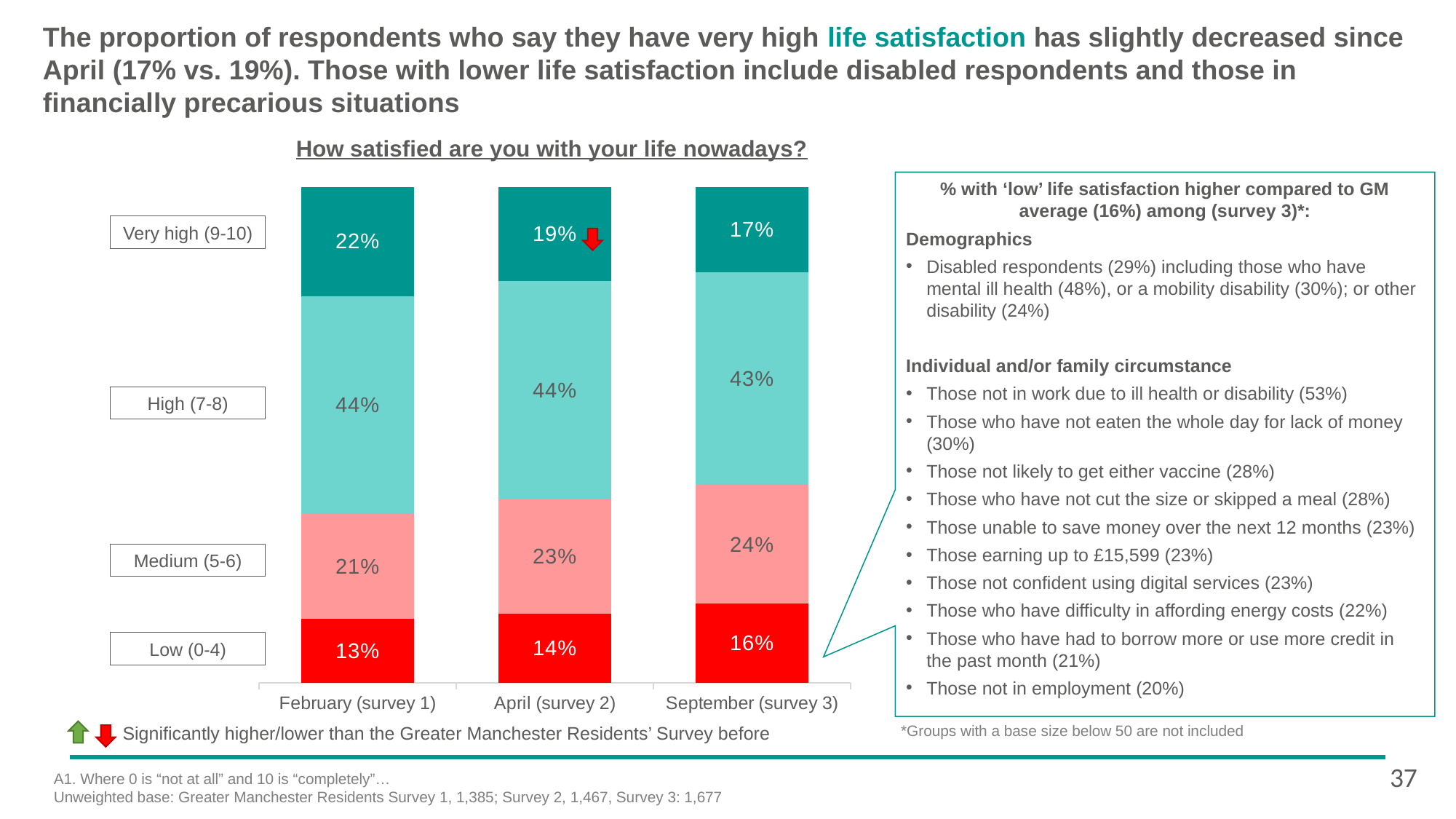
Which is larger: the medium (5-6) share in February (survey 1) or in September (survey 3)? September (survey 3) What percentage of respondents reported low (0-4) life satisfaction in February (survey 1)? 13% What type of chart is used to show life satisfaction by survey wave? Stacked bar chart What percentage of respondents reported medium (5-6) life satisfaction in April (survey 2)? 23% Does the share of respondents with low (0-4) life satisfaction rise or fall across the three survey waves? Rise In which survey wave was the share of respondents with low (0-4) life satisfaction highest? September (survey 3) What is the title of the chart? How satisfied are you with your life nowadays? How many life satisfaction categories are stacked in each bar? 4 In which survey wave was the share of respondents with very high (9-10) life satisfaction lowest? September (survey 3) By how many percentage points did the very high (9-10) share fall from February (survey 1) to September (survey 3)? 5 percentage points How many survey waves are shown as bars in the chart? 3 What percentage of respondents reported very high (9-10) life satisfaction in September (survey 3)? 17%